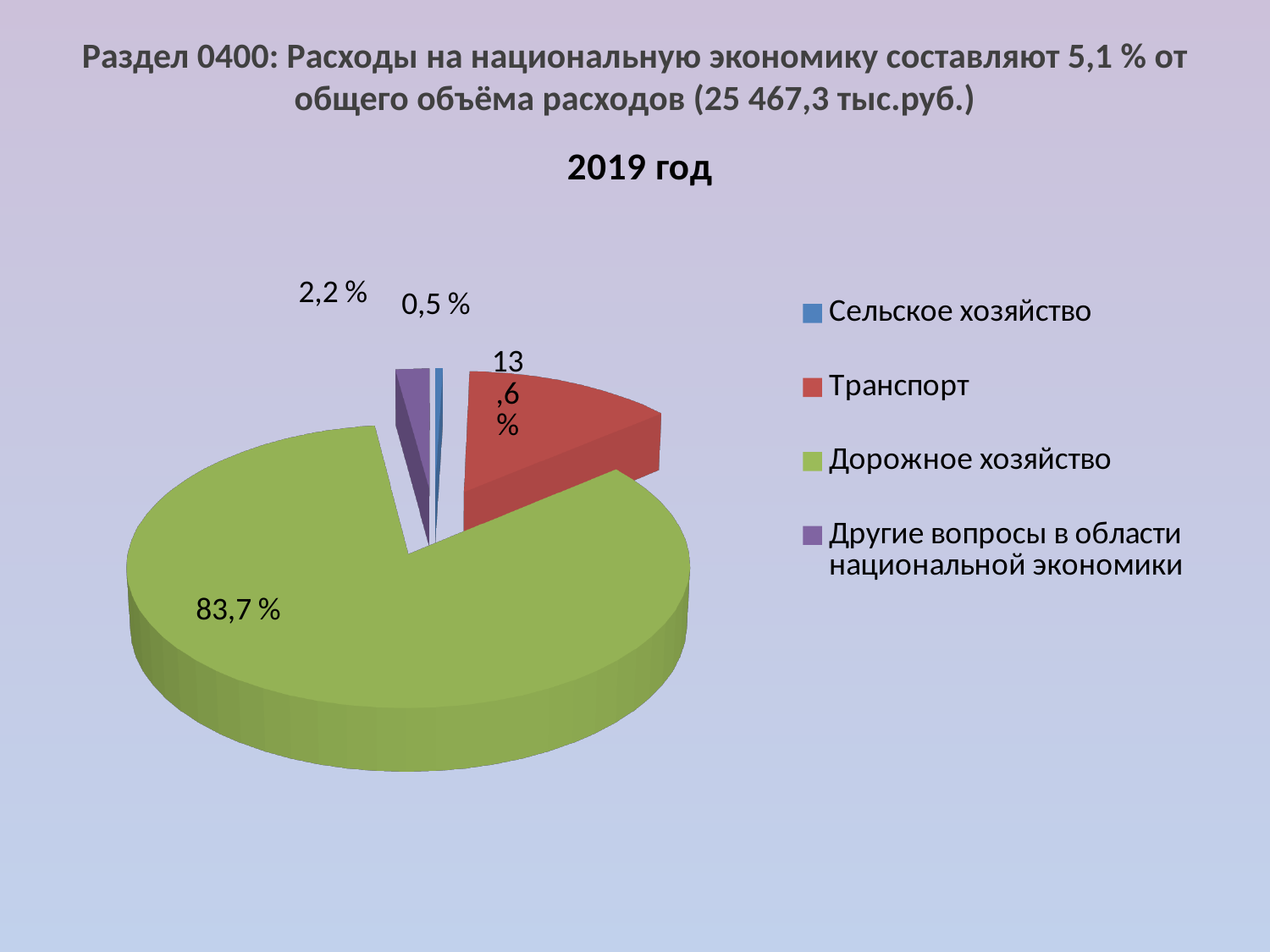
What share of the pie does Транспорт have? 13,6 % Which category has the largest slice of the pie? Дорожное хозяйство What is the difference in percentage points between the shares of Другие вопросы в области национальной экономики and Сельское хозяйство? 1,7 What year is shown in the chart title? 2019 год What share of the pie does Сельское хозяйство have? 0,5 % What share of the pie does Другие вопросы в области национальной экономики have? 2,2 % What kind of chart is shown on the slide? pie chart How many categories does the pie chart show? 4 Which is larger, the share for Транспорт or the share for Другие вопросы в области национальной экономики? Транспорт Which category has the smallest slice of the pie? Сельское хозяйство What is the difference in percentage points between the shares of Дорожное хозяйство and Транспорт? 70,1